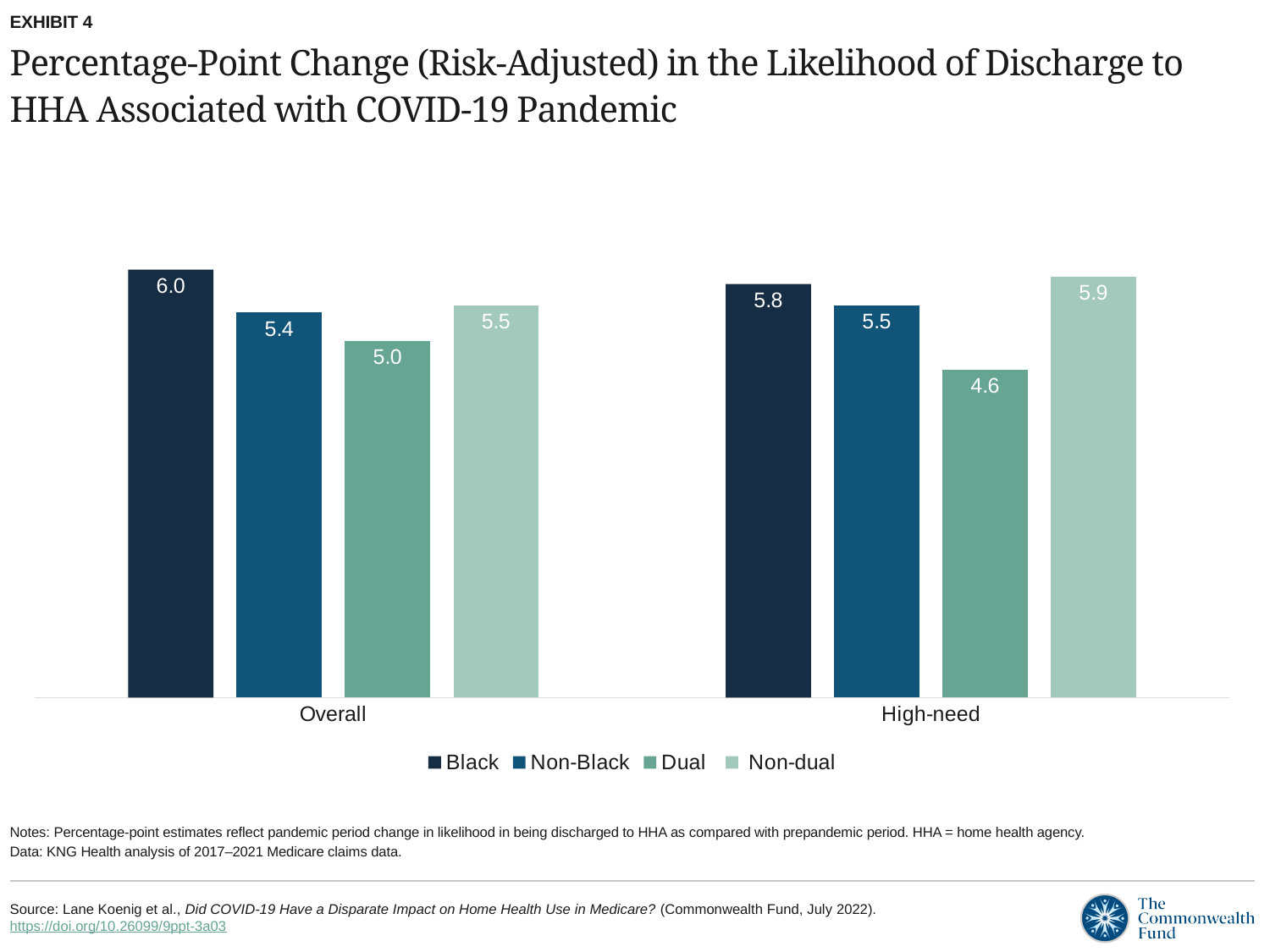
Which is larger in the High-need group: Black or Non-dual? Non-dual What is the difference between the Black and Dual values in the Overall group? 1.0 What is the value for Non-dual in the Overall group? 5.5 Which series has the lowest value in the High-need group? Dual What is the value for Dual in the High-need group? 4.6 How many series does the legend list? 4 How many category groups are shown on the x axis? 2 What kind of chart is this? Bar chart What is the value for Non-Black in the High-need group? 5.5 What is the value for Black in the Overall group? 6.0 What is the difference between the Non-dual and Dual values in the High-need group? 1.3 Which series has the highest value in the Overall group? Black